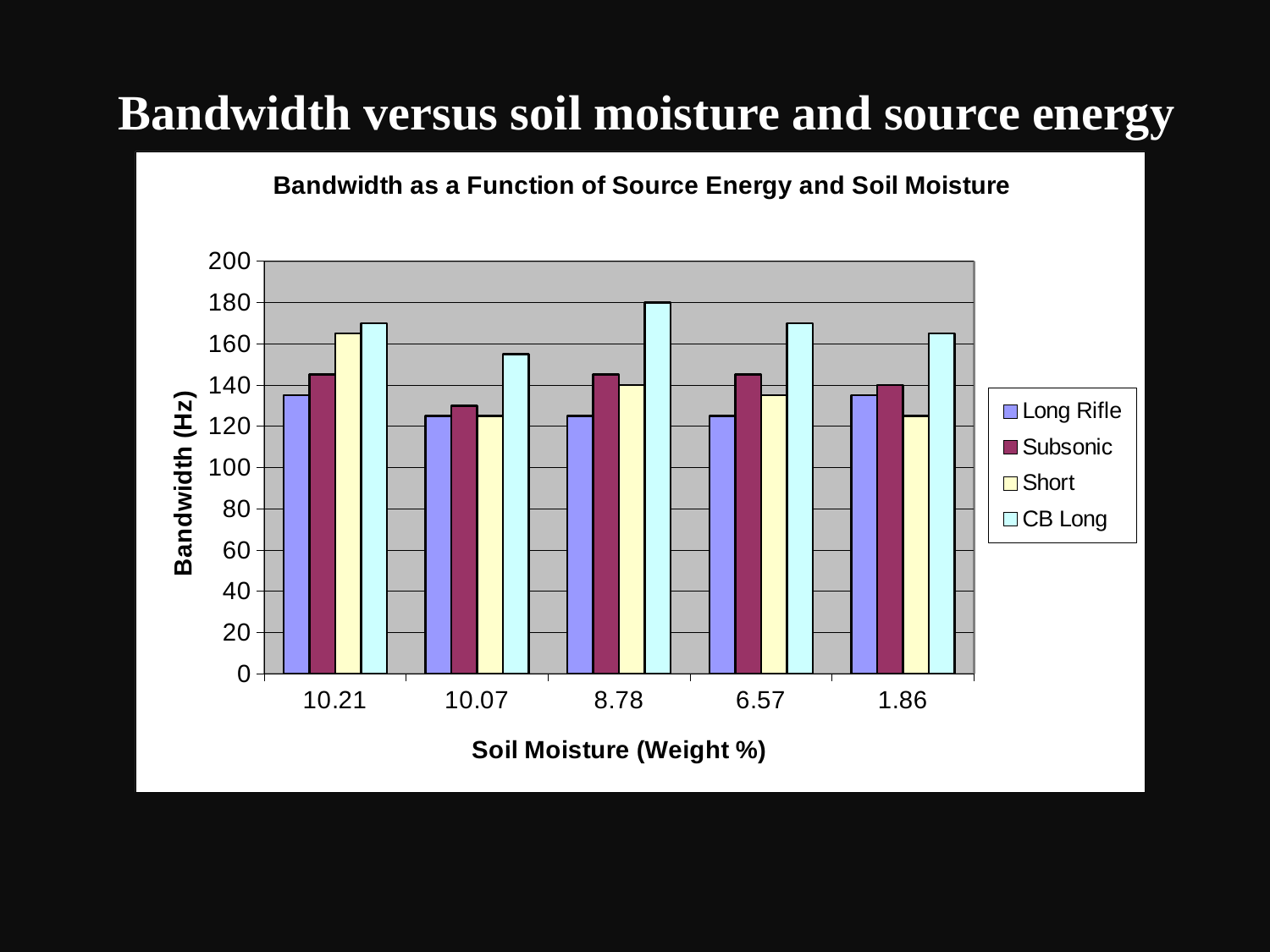
What is the title of the chart? Bandwidth as a Function of Source Energy and Soil Moisture What is the label of the y axis? Bandwidth (Hz) At which soil moisture value is the CB Long bar highest? 8.78 How many series does the legend list? 4 At 8.78 soil moisture, which is larger, the Subsonic value or the Long Rifle value? Subsonic Is the Long Rifle value at 10.21 soil moisture greater or less than 120? greater Is the Subsonic value at 10.07 soil moisture greater or less than 140? less What kind of chart is shown on the slide? bar chart How many soil moisture categories are shown on the x axis? 5 Is the CB Long value at 10.07 soil moisture greater or less than 160? less At 10.21 soil moisture, which is larger, the CB Long value or the Long Rifle value? CB Long What is the CB Long bandwidth at 8.78 soil moisture? 180